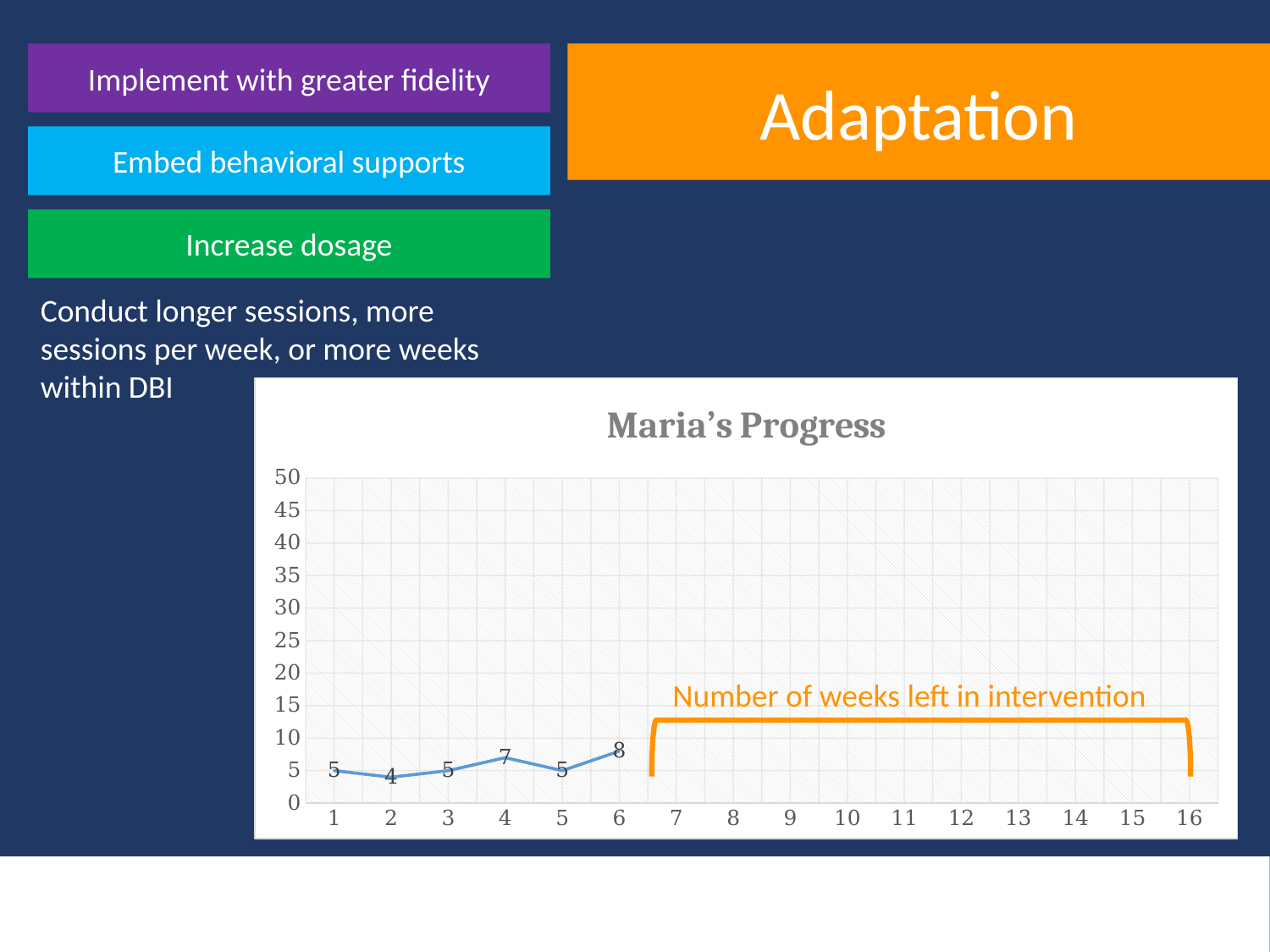
At which week is the plotted value highest? 6 What is the highest value shown on the vertical axis? 50 Which is larger, the value at week 4 or the value at week 5? week 4 What is the difference between the values at week 6 and week 2? 4 What is the value plotted at week 6? 8 What is the value plotted at week 2? 4 What kind of chart is shown on the slide? line chart How many weeks have a plotted data point? 6 What is the title of the chart? Maria's Progress What is the value plotted at week 4? 7 What is the value plotted at week 1? 5 At which week is the plotted value lowest? 2